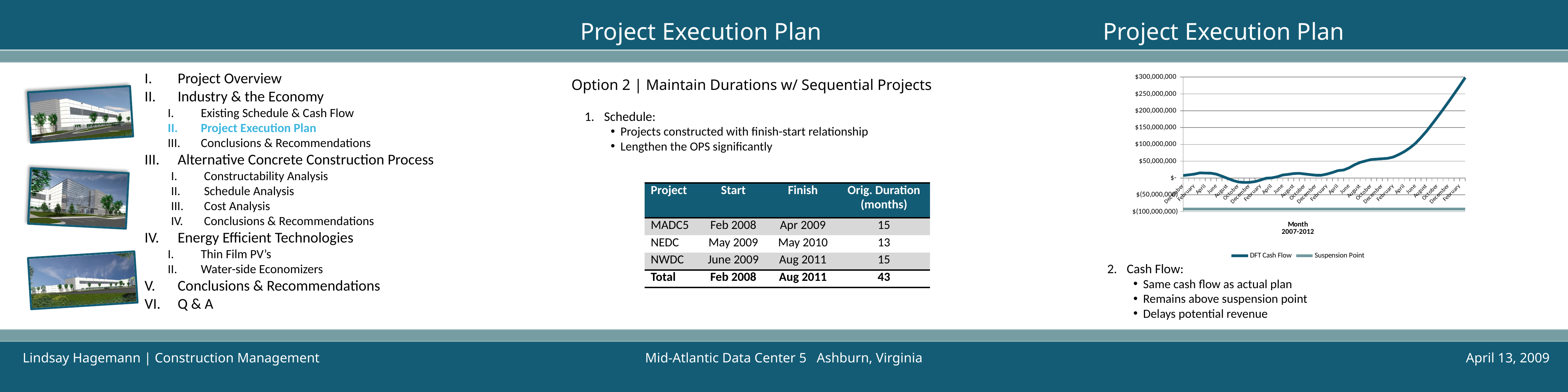
What is the title of the chart's x axis? Month 2007-2012 How many series does the chart's legend list? 2 Is the final value of the DFT Cash Flow line greater or less than $250,000,000? greater What are the two series named in the chart's legend? DFT Cash Flow and Suspension Point At the right end of the chart, which series has the higher value, DFT Cash Flow or Suspension Point? DFT Cash Flow What is the highest value labelled on the chart's y axis? $300,000,000 What kind of chart is shown on the slide? line chart Does the DFT Cash Flow line overall rise or fall from left to right along the x axis? rise Is the Suspension Point line above or below the $(50,000,000) gridline? below Is the DFT Cash Flow value at the start of the chart greater or less than $100,000,000? less